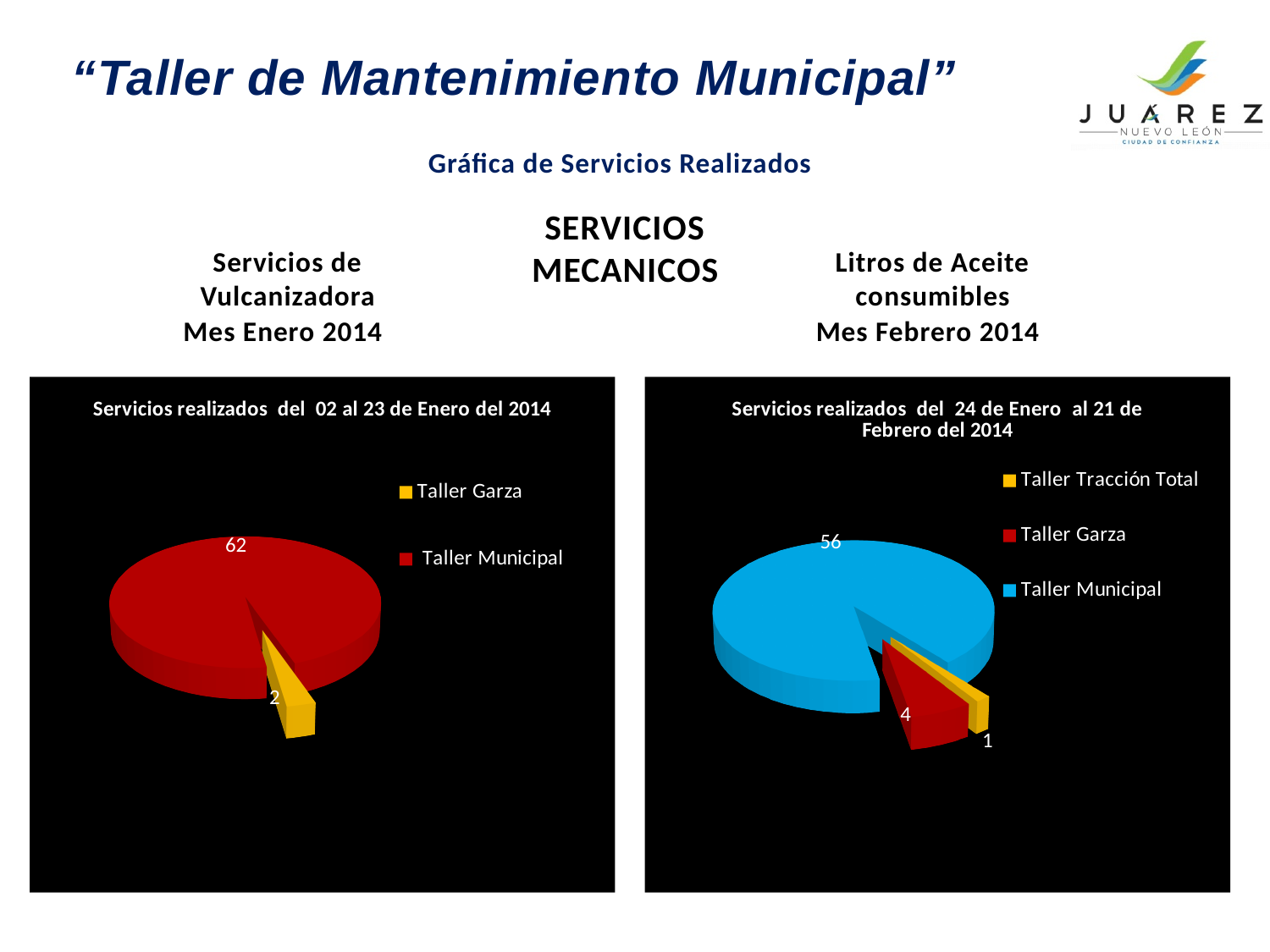
In the left chart (Servicios realizados del 02 al 23 de Enero del 2014), what is the difference between Taller Municipal and Taller Garza? 60 In the right chart (Servicios realizados del 24 de Enero al 21 de Febrero del 2014), which is larger, Taller Garza or Taller Tracción Total? Taller Garza In the right chart (Servicios realizados del 24 de Enero al 21 de Febrero del 2014), what colour represents Taller Municipal? Blue In the left chart (Servicios realizados del 02 al 23 de Enero del 2014), what is the value for Taller Garza? 2 In the right chart (Servicios realizados del 24 de Enero al 21 de Febrero del 2014), which category has the lowest value? Taller Tracción Total In the right chart (Servicios realizados del 24 de Enero al 21 de Febrero del 2014), what is the difference between Taller Garza and Taller Tracción Total? 3 In the right chart (Servicios realizados del 24 de Enero al 21 de Febrero del 2014), what is the value for Taller Tracción Total? 1 How many categories does the legend of the right chart (Servicios realizados del 24 de Enero al 21 de Febrero del 2014) list? 3 What kind of chart is the left chart (Servicios realizados del 02 al 23 de Enero del 2014)? Pie chart In the left chart (Servicios realizados del 02 al 23 de Enero del 2014), what is the value for Taller Municipal? 62 In the right chart (Servicios realizados del 24 de Enero al 21 de Febrero del 2014), what is the value for Taller Municipal? 56 In the left chart (Servicios realizados del 02 al 23 de Enero del 2014), which category has the highest value? Taller Municipal